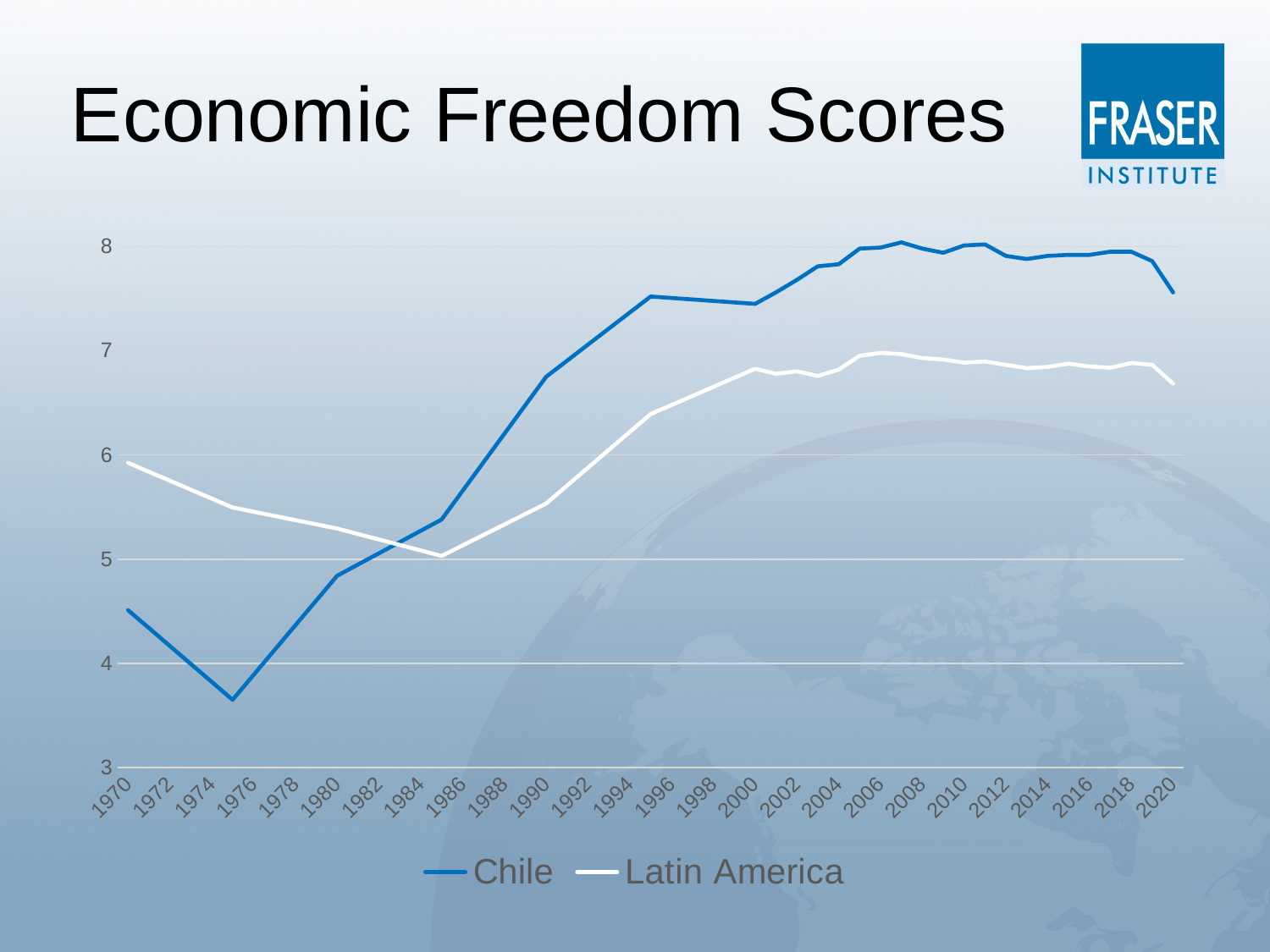
How many series does the legend list? 2 In which year does the Latin America line reach its lowest value? 1985 What kind of chart is shown on the slide? line chart Is the value for Chile in 2020 greater or less than 7? greater Is the value for Latin America in 2020 greater or less than 7? less Which series has the higher value in 2020, Chile or Latin America? Chile Which series is drawn with the white line? Latin America In which year does the Chile line reach its lowest value? 1975 Is the value for Chile in 1970 greater or less than 5? less What is the title of the chart on the slide? Economic Freedom Scores Which series has the higher value in 1970, Chile or Latin America? Latin America